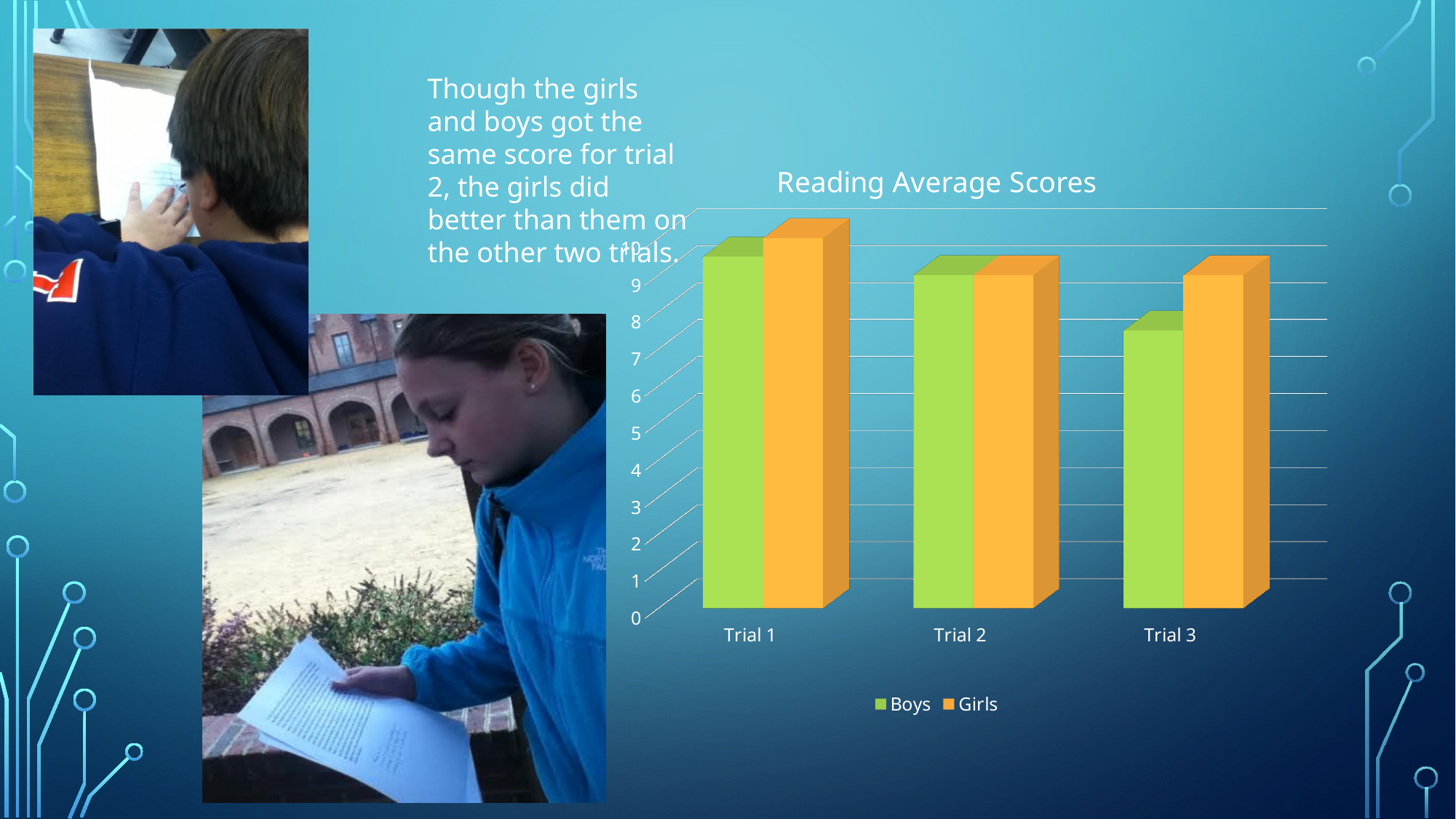
What type of chart is shown on the slide? bar chart In which trial do the Boys have their lowest score? Trial 3 Do the Boys scores rise or fall from Trial 1 to Trial 3? fall What is the title of the chart? Reading Average Scores Is the Girls value for Trial 1 greater or less than 9? greater How many trials are shown on the x axis? 3 In Trial 3, which is larger, the Boys score or the Girls score? Girls Is the Boys value for Trial 3 greater or less than 9? less Which series is shown in orange? Girls In which trial do the Girls have their highest score? Trial 1 How many series does the legend list? 2 Is the Boys value for Trial 2 greater or less than 5? greater